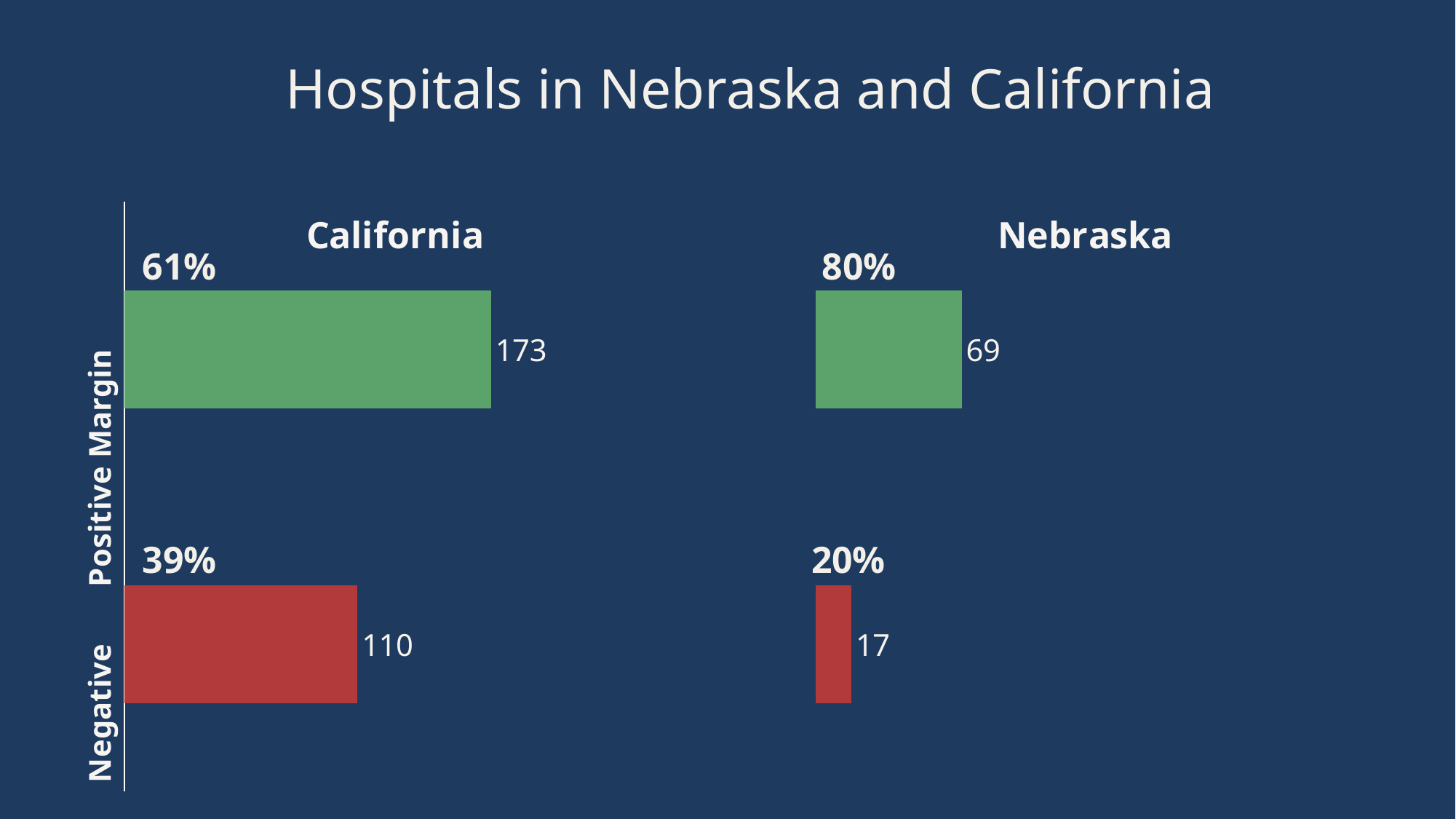
In the Nebraska chart, what is the difference between the positive-margin count and the negative-margin count? 52 In the California chart, which category has the larger bar, Positive Margin or Negative? Positive Margin What kind of chart is used on this slide? Bar chart In the California chart, what is the difference between the number of hospitals with a positive margin and those with a negative margin? 63 In the Nebraska chart, which category has the smaller bar? Negative In the Nebraska chart, how many hospitals have a negative margin? 17 Which is larger: the number of negative-margin hospitals in California or the number of positive-margin hospitals in Nebraska? California negative-margin hospitals In the California chart, how many hospitals have a positive margin? 173 In the Nebraska chart, what percentage of hospitals have a positive margin? 80% In the California chart, what percentage of hospitals have a negative margin? 39% What is the title of the slide? Hospitals in Nebraska and California What is the total number of hospitals shown for Nebraska (positive plus negative)? 86